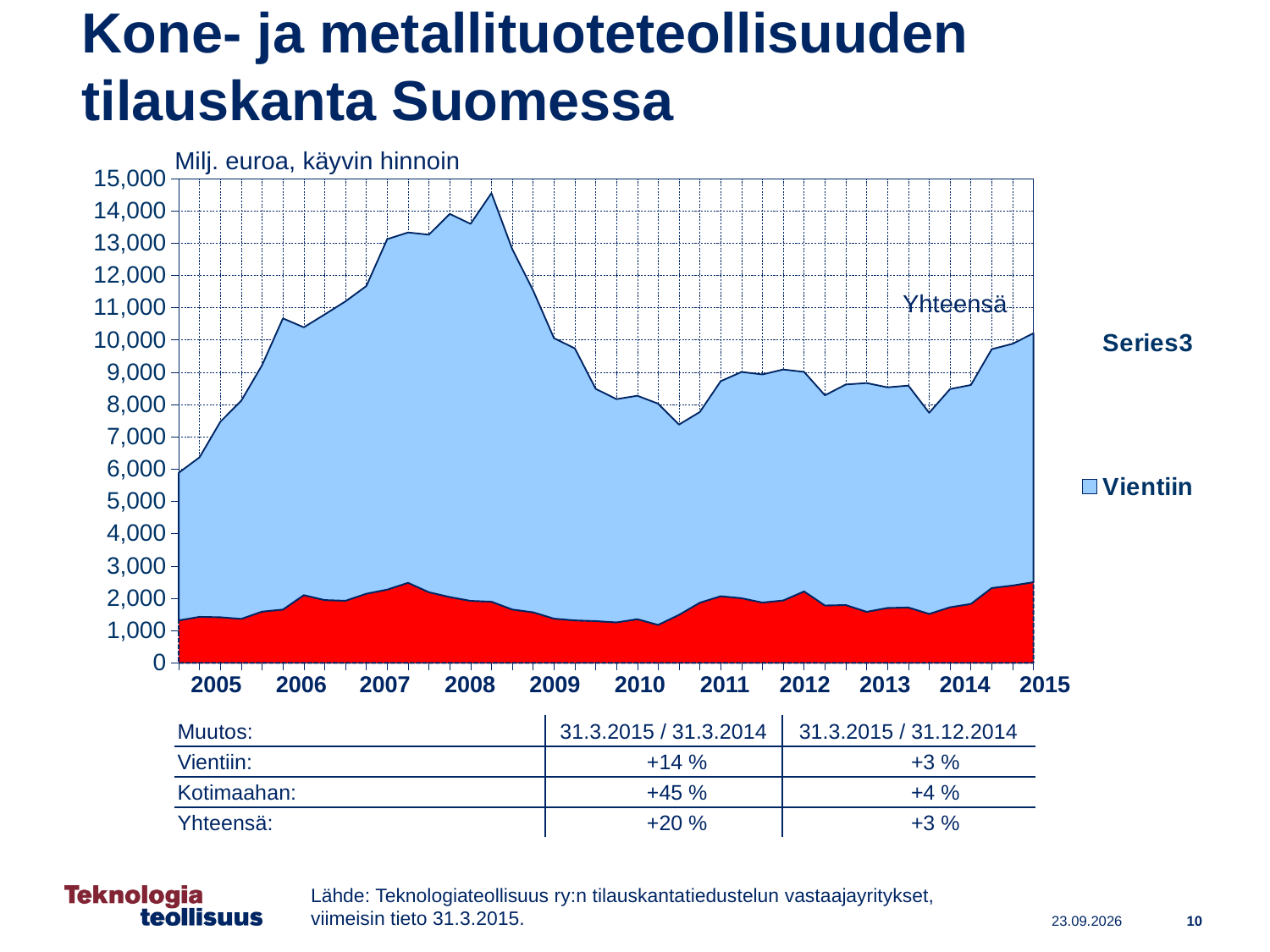
Is the total order backlog at the end of the series in 2015 greater or less than 9,000? greater What kind of chart is shown on the slide? Area chart In which year does the total (Yhteensä) order backlog reach its highest point? 2008 Does the total order backlog rise or fall between the 2008 peak and 2010? fall How many series does the chart legend list? 2 Is the peak value of the total order backlog in 2008 greater or less than 14,000? greater What are the two entries in the chart legend? Series3 and Vientiin What unit label is shown above the chart? Milj. euroa, käyvin hinnoin Is the red (domestic) area at the end of the series in 2015 greater or less than 2,000? greater How many years are labelled on the x axis of the chart? 11 Does the total order backlog rise or fall from 2005 to 2008? rise